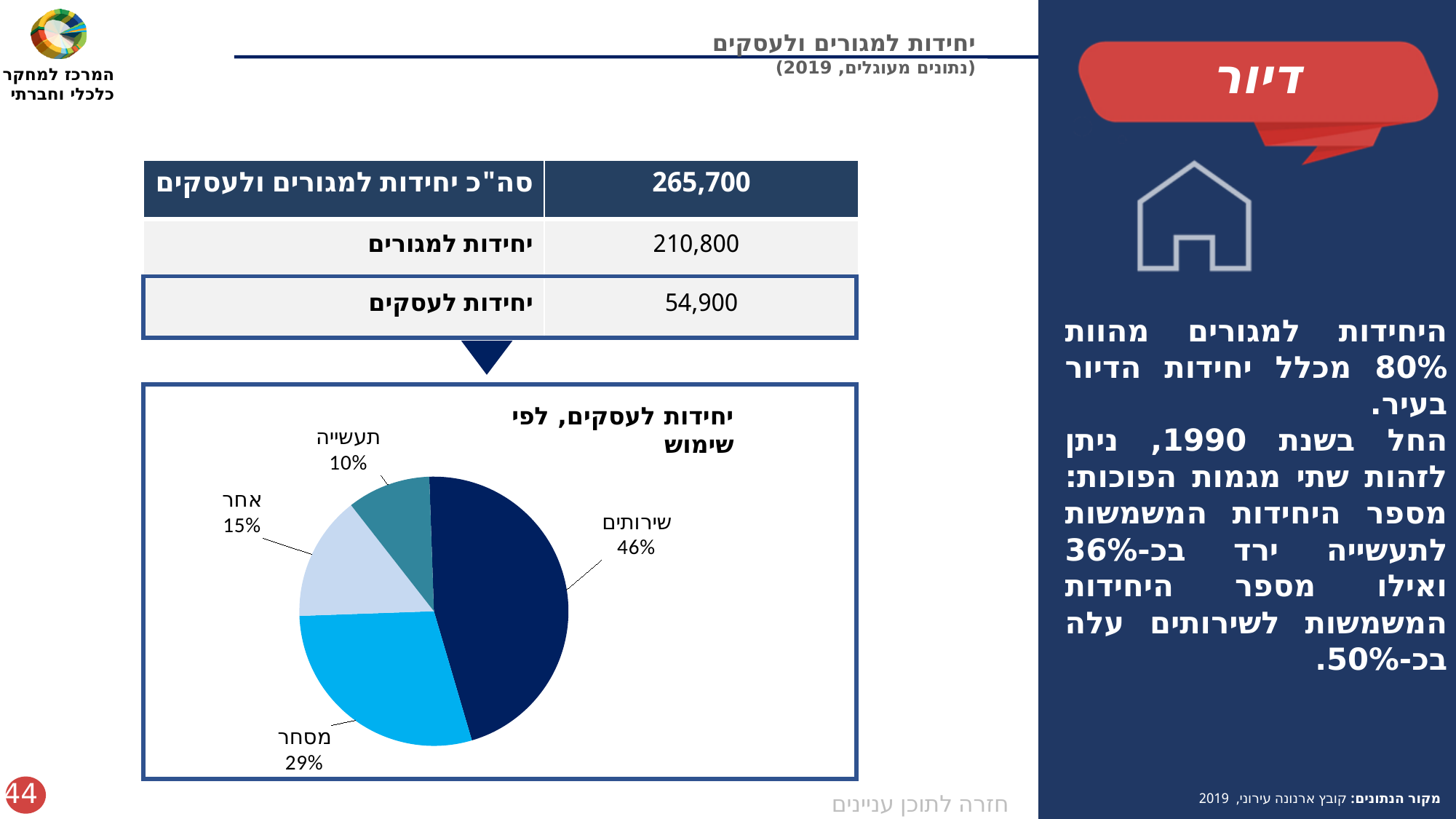
What is the difference in percentage points between שירותים and מסחר? 17 What is the combined share of מסחר and אחר? 44% Which is larger, the share for אחר or the share for תעשייה? אחר What kind of chart is shown on the slide? pie chart What share of the pie does שירותים hold? 46% What is the title of the pie chart? יחידות לעסקים, לפי שימוש Which category has the largest slice of the pie? שירותים Which category has the smallest slice of the pie? תעשייה What share of the pie does תעשייה hold? 10% How many slices does the pie chart have? 4 What share of the pie does מסחר hold? 29% What share of the pie does אחר hold? 15%